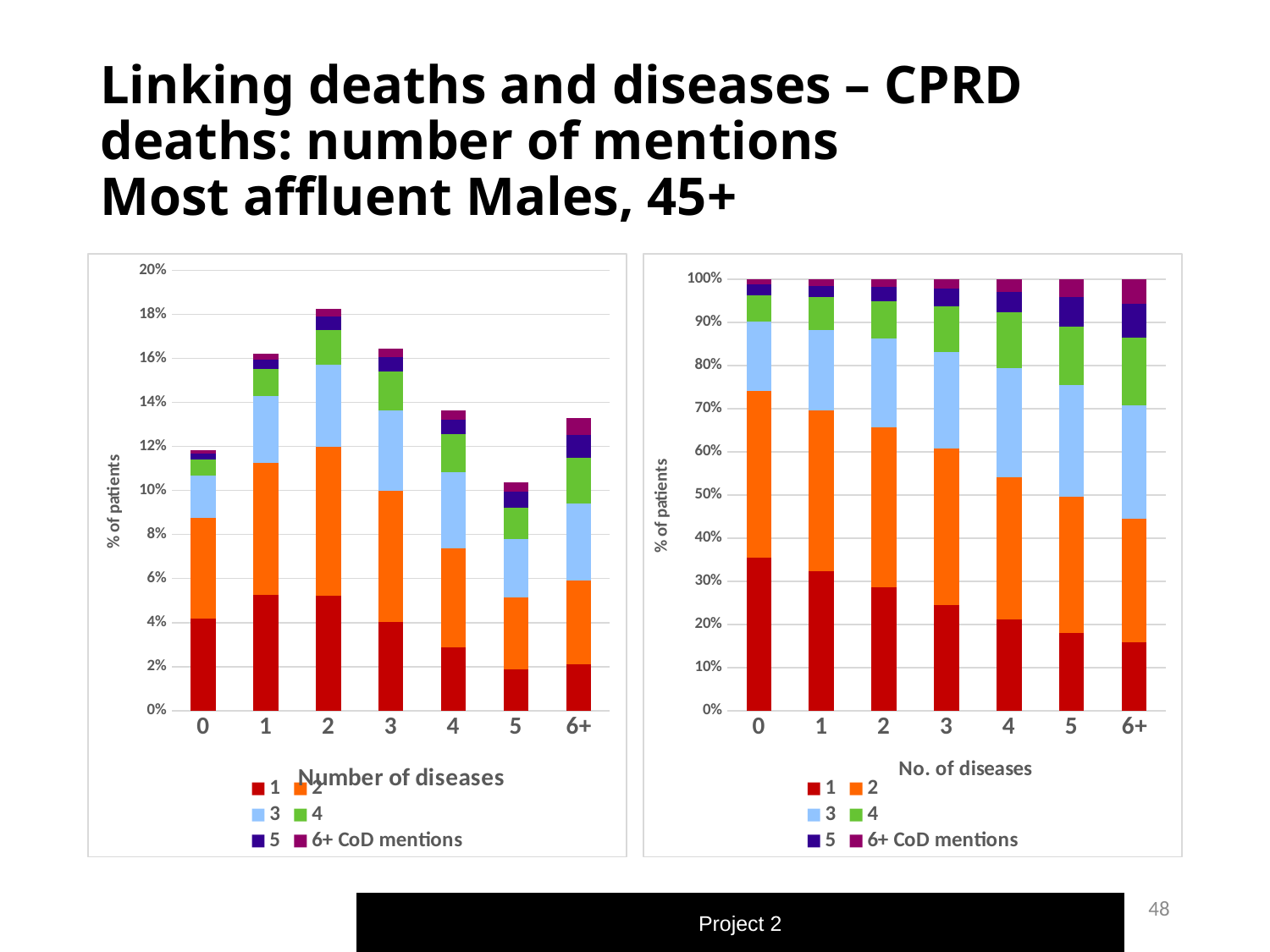
In the right chart, is the red segment (1 CoD mention) for 6+ diseases greater or less than 20%? less In the left chart, is the total stacked bar for 0 diseases taller than the bar for 5 diseases? Yes In the right chart, is the red segment (1 CoD mention) for 0 diseases greater or less than 30%? greater In the left chart, which number of diseases has the shortest stacked bar? 5 What is the x-axis title of the right chart? No. of diseases How many categories are shown on the x axis of the right chart? 7 In the left chart, is the total height of the bar for 2 diseases greater or less than 16%? greater In the right chart, does the share of the red series (1 CoD mention) rise or fall as the number of diseases increases? fall In the left chart, which number of diseases has the tallest stacked bar? 2 What kind of chart is the left chart on the slide? stacked bar chart How many series does the legend of the left chart list? 6